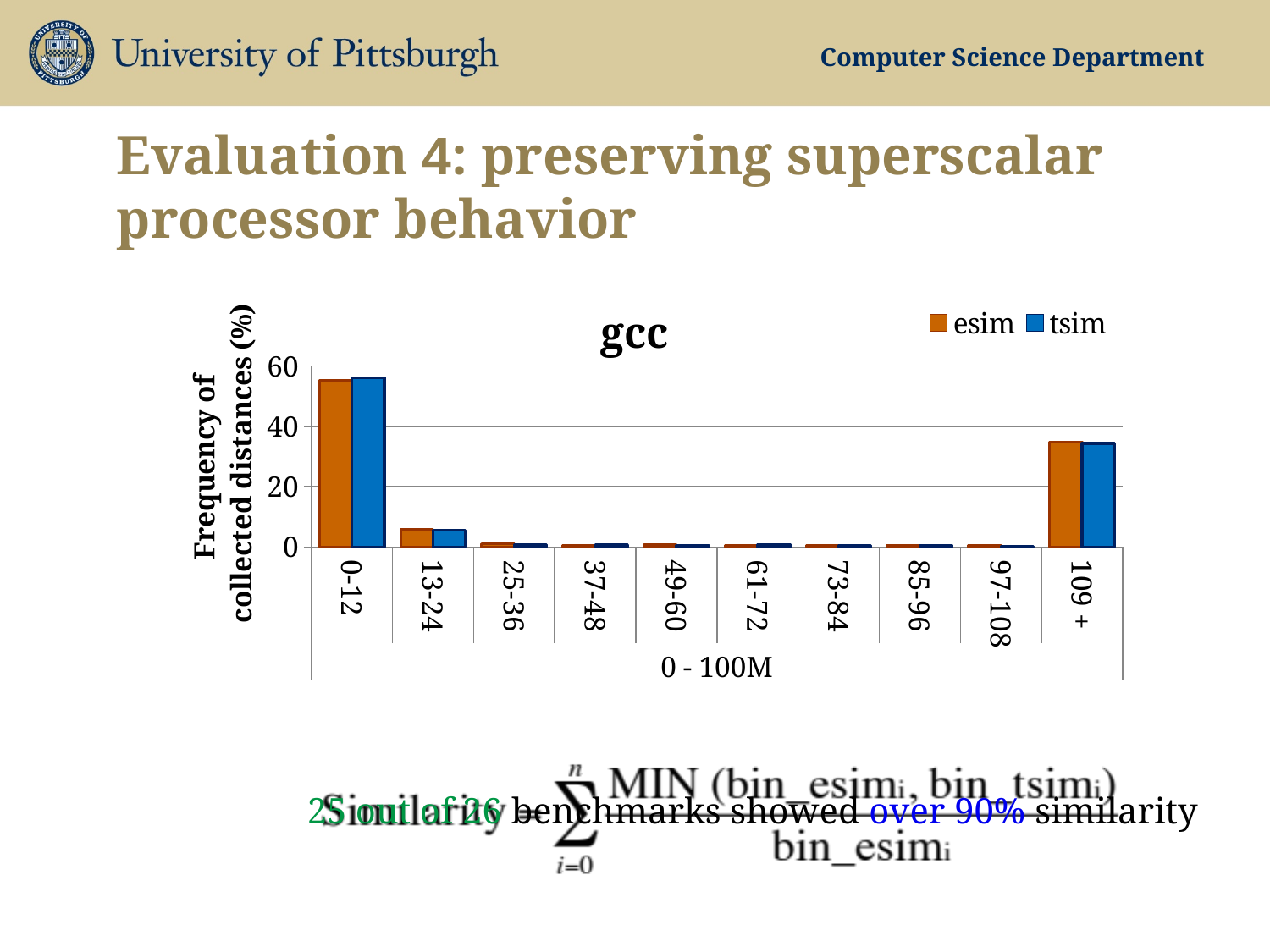
Is the esim value for the 13-24 category greater or less than 20? less What kind of chart is shown on the slide? bar chart Is the esim value for the 0-12 category greater or less than 40? greater Which category has the highest value for the tsim series? 0-12 How many series does the chart legend list? 2 Is the esim value for the 109 + category greater or less than 20? greater Which category has the highest value for the esim series? 0-12 How many categories are shown along the x axis of the chart? 10 For the esim series, which is larger: the value for 0-12 or the value for 109 +? 0-12 What is the title of the chart? gcc For the tsim series, which is larger: the value for 13-24 or the value for 109 +? 109 +